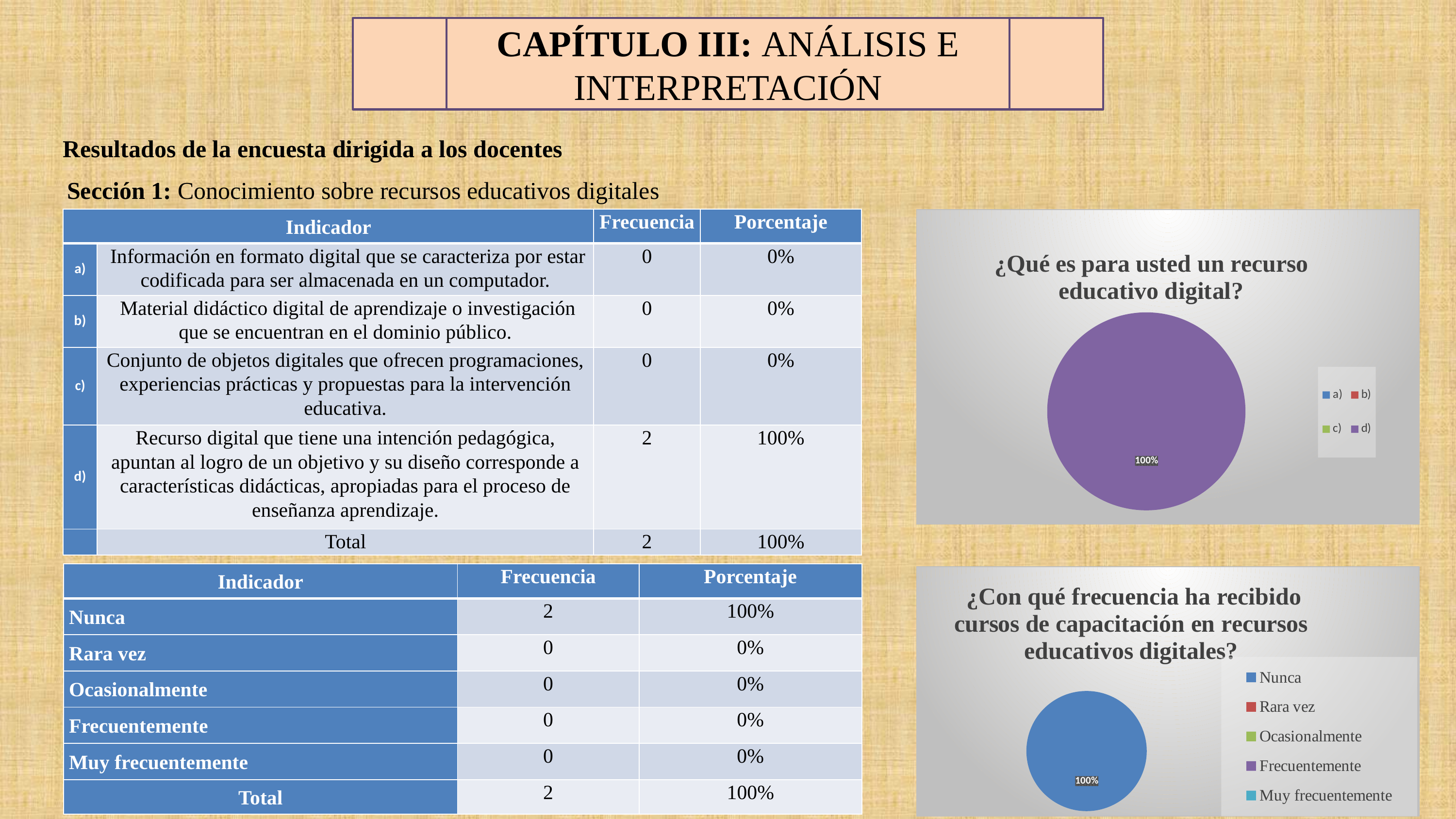
In the chart titled "¿Qué es para usted un recurso educativo digital?", what kind of chart is shown? pie chart In the chart titled "¿Con qué frecuencia ha recibido cursos de capacitación en recursos educativos digitales?", which legend entry is shown in blue? Nunca In the chart titled "¿Con qué frecuencia ha recibido cursos de capacitación en recursos educativos digitales?", what is the data label shown on the pie? 100% In the chart titled "¿Qué es para usted un recurso educativo digital?", how many entries does the legend list? 4 In the chart titled "¿Con qué frecuencia ha recibido cursos de capacitación en recursos educativos digitales?", what kind of chart is shown? pie chart In the chart titled "¿Qué es para usted un recurso educativo digital?", which category has the largest share? d) In the chart titled "¿Con qué frecuencia ha recibido cursos de capacitación en recursos educativos digitales?", which category has the largest share? Nunca In the chart titled "¿Qué es para usted un recurso educativo digital?", which legend entry corresponds to the purple slice that fills the whole pie? d) In the chart titled "¿Qué es para usted un recurso educativo digital?", what share of the pie does the single visible slice have according to its data label? 100% In the chart titled "¿Con qué frecuencia ha recibido cursos de capacitación en recursos educativos digitales?", how many entries does the legend list? 5 How many pie charts are on the slide? 2